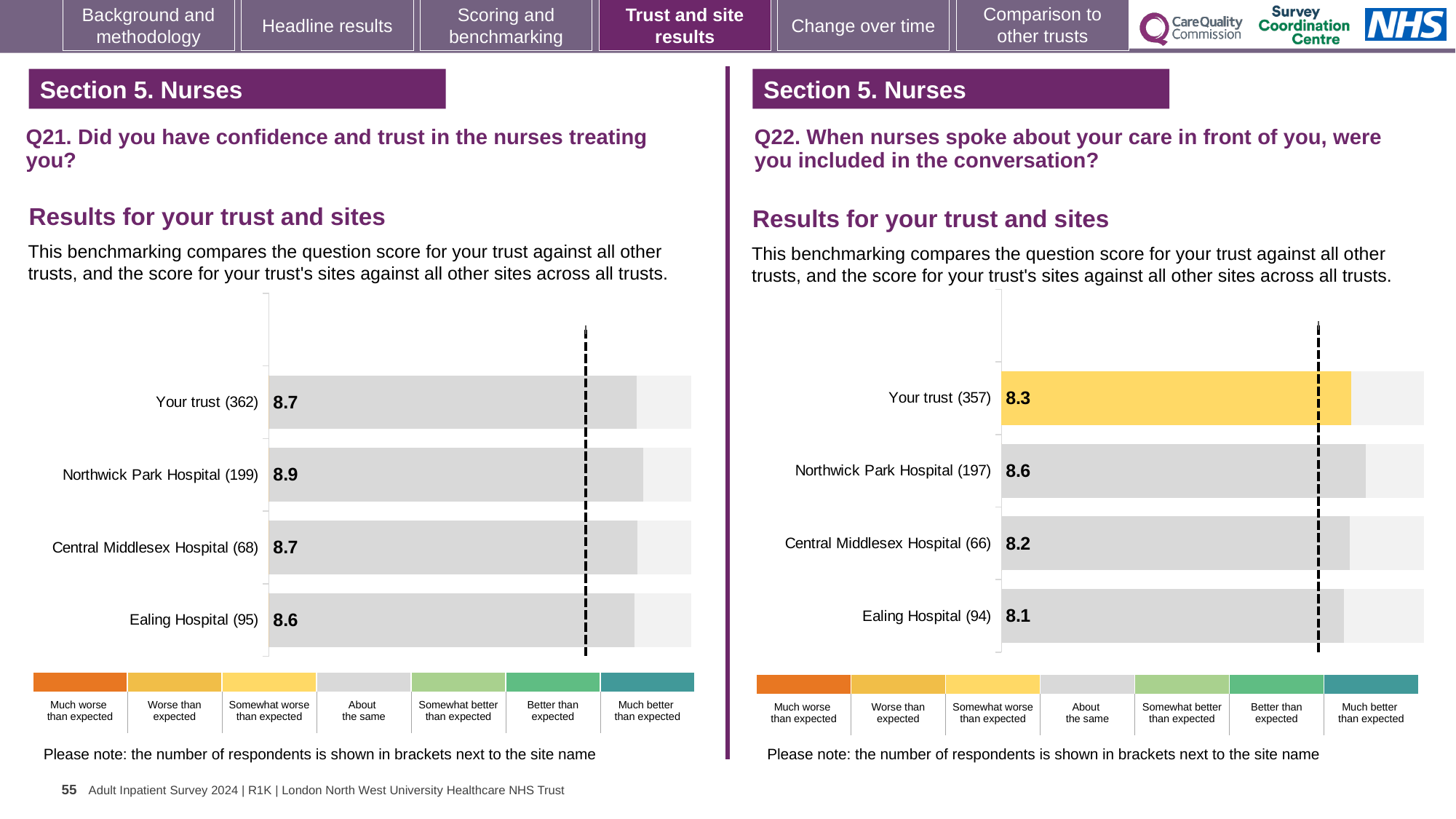
On the Q21 chart (left), what is the score for Your trust? 8.7 On the Q21 chart (left), which site has the lowest score? Ealing Hospital On the Q21 chart (left), what is the score for Northwick Park Hospital? 8.9 On the Q22 chart (right), which site has the highest score? Northwick Park Hospital On the Q22 chart (right), what is the score for Central Middlesex Hospital? 8.2 On the Q22 chart (right), which site has the lowest score? Ealing Hospital How many bars are plotted on the Q22 chart (right)? 4 What type of chart is used on the Q21 chart (left)? Bar chart On the Q22 chart (right), what is the score for Your trust? 8.3 On the Q21 chart (left), which site has the highest score? Northwick Park Hospital On the Q22 chart (right), which is larger: the score for Northwick Park Hospital or Ealing Hospital? Northwick Park Hospital On the Q21 chart (left), what is the difference between the scores for Northwick Park Hospital and Ealing Hospital? 0.3